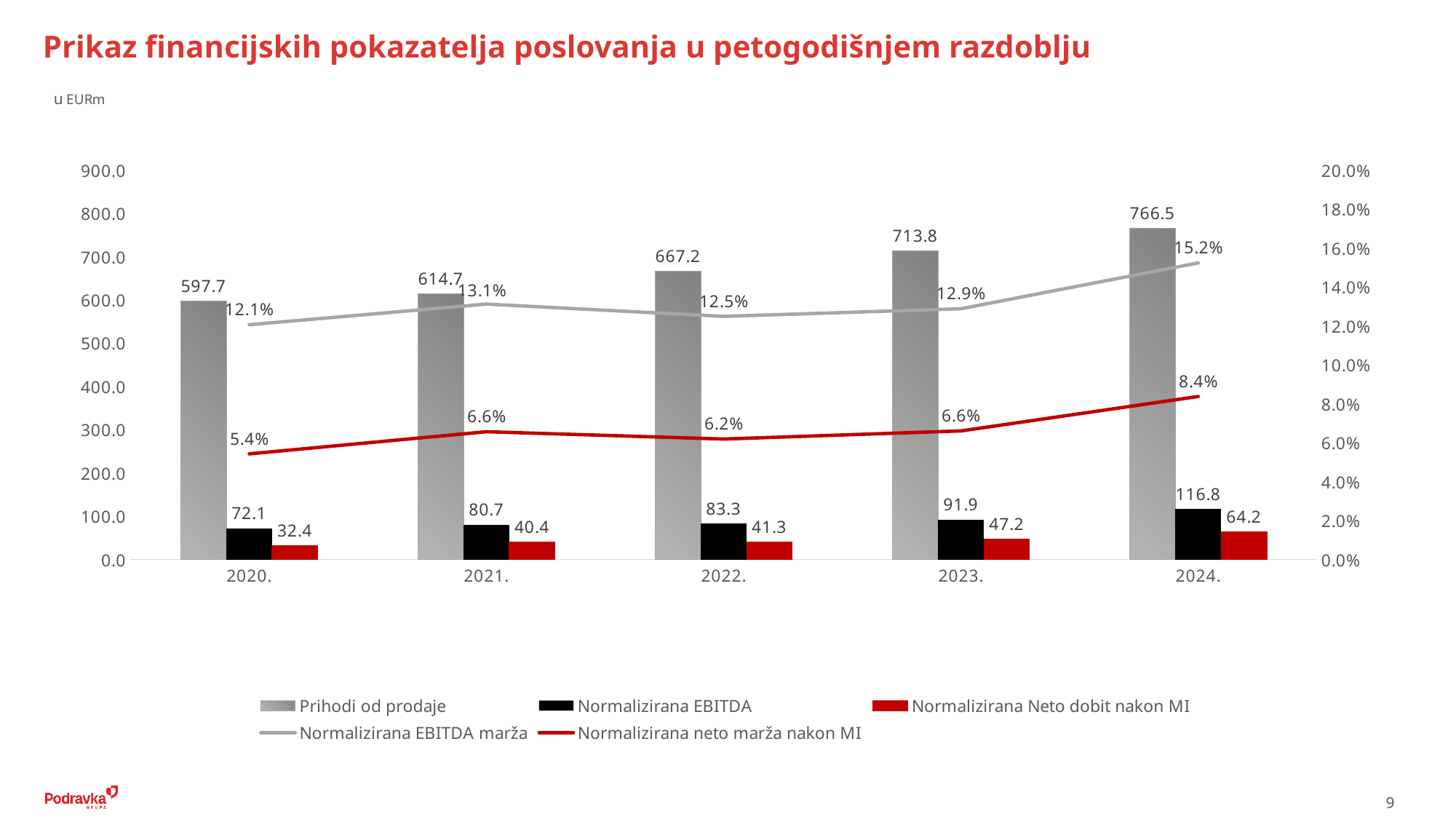
Does Prihodi od prodaje rise or fall from 2020. to 2024.? rise What is the Normalizirana neto marža nakon MI for 2024.? 8.4% Which year has the highest Prihodi od prodaje? 2024. What is the Normalizirana EBITDA marža for 2020.? 12.1% What is the Normalizirana Neto dobit nakon MI value for 2022.? 41.3 What is the Normalizirana EBITDA value for 2021.? 80.7 Which year has the lowest Normalizirana Neto dobit nakon MI? 2020. How many series does the legend list? 5 What is the difference in Prihodi od prodaje between 2024. and 2023.? 52.7 What is the value of Prihodi od prodaje for 2024.? 766.5 How many years are shown on the x axis? 5 Which is larger: Normalizirana EBITDA in 2022. or in 2023.? 2023.